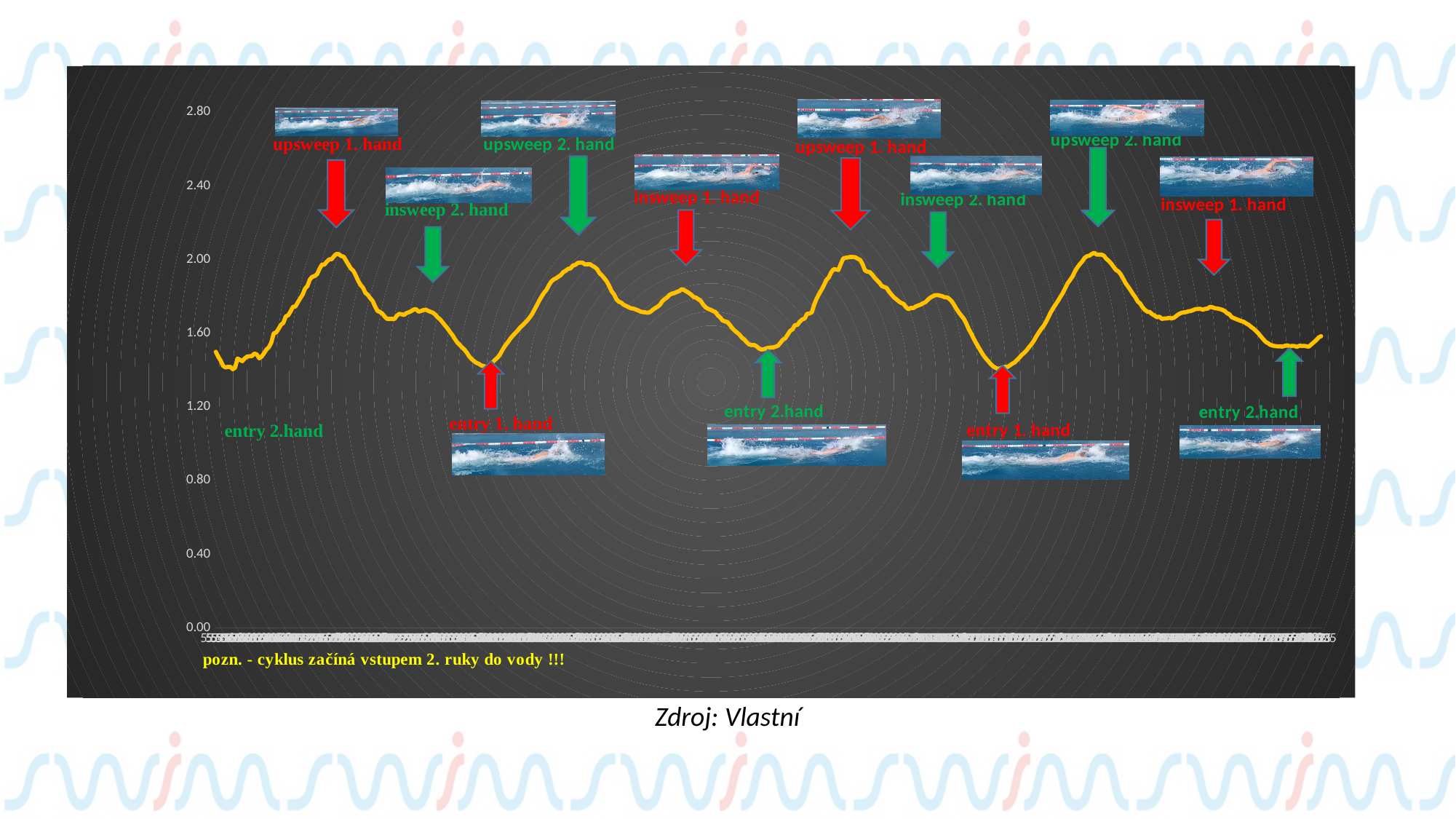
Is the value of the line at the first 'entry 1. hand' trough greater or less than 1.20? greater What is the highest value labelled on the vertical axis? 2.80 Is the value of the line at the first 'upsweep 2. hand' peak greater or less than 2.40? less Is the value of the line at the first 'entry 1. hand' trough greater or less than 1.60? less How many peaks on the line are labelled with an 'upsweep' annotation? 4 What kind of chart is shown on the slide? line chart What colour is the plotted line? yellow Does the line rise or fall between the first 'upsweep 1. hand' peak and the first 'entry 1. hand' trough? fall Which is higher on the chart: the first 'upsweep 1. hand' peak or the first 'entry 1. hand' trough? upsweep 1. hand Does the line rise or fall from the first 'entry 1. hand' trough to the first 'upsweep 2. hand' peak? rise